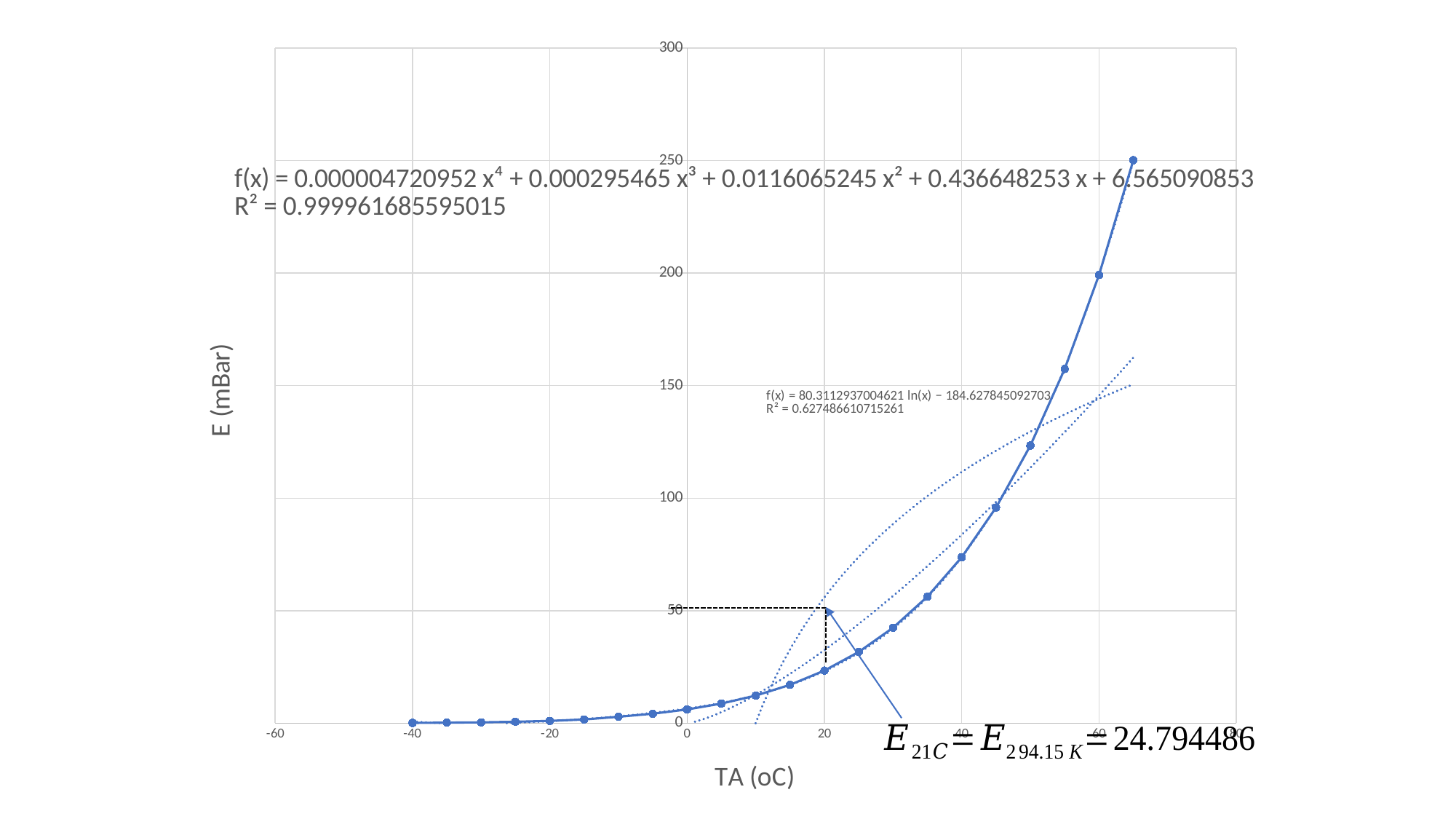
Is the plotted E value at TA = 60 greater or less than 150? greater Is the plotted E value at TA = 40 greater or less than 100? less What is the title of the y axis? E (mBar) What is the R² value of the polynomial fit shown at the top of the chart? 0.999961685595015 According to the annotation on the slide, what is the value of E at 21 °C (294.15 K)? 24.794486 Which has the larger plotted E value: TA = 60 or TA = 40? TA = 60 Do the plotted values rise or fall as TA increases along the x axis? Rise Is the plotted E value at TA = 20 greater or less than 50? less How many data points are plotted on the chart? 22 What kind of chart is shown on the slide? Scatter chart with a fitted line At which TA value is the plotted E value lowest? -40